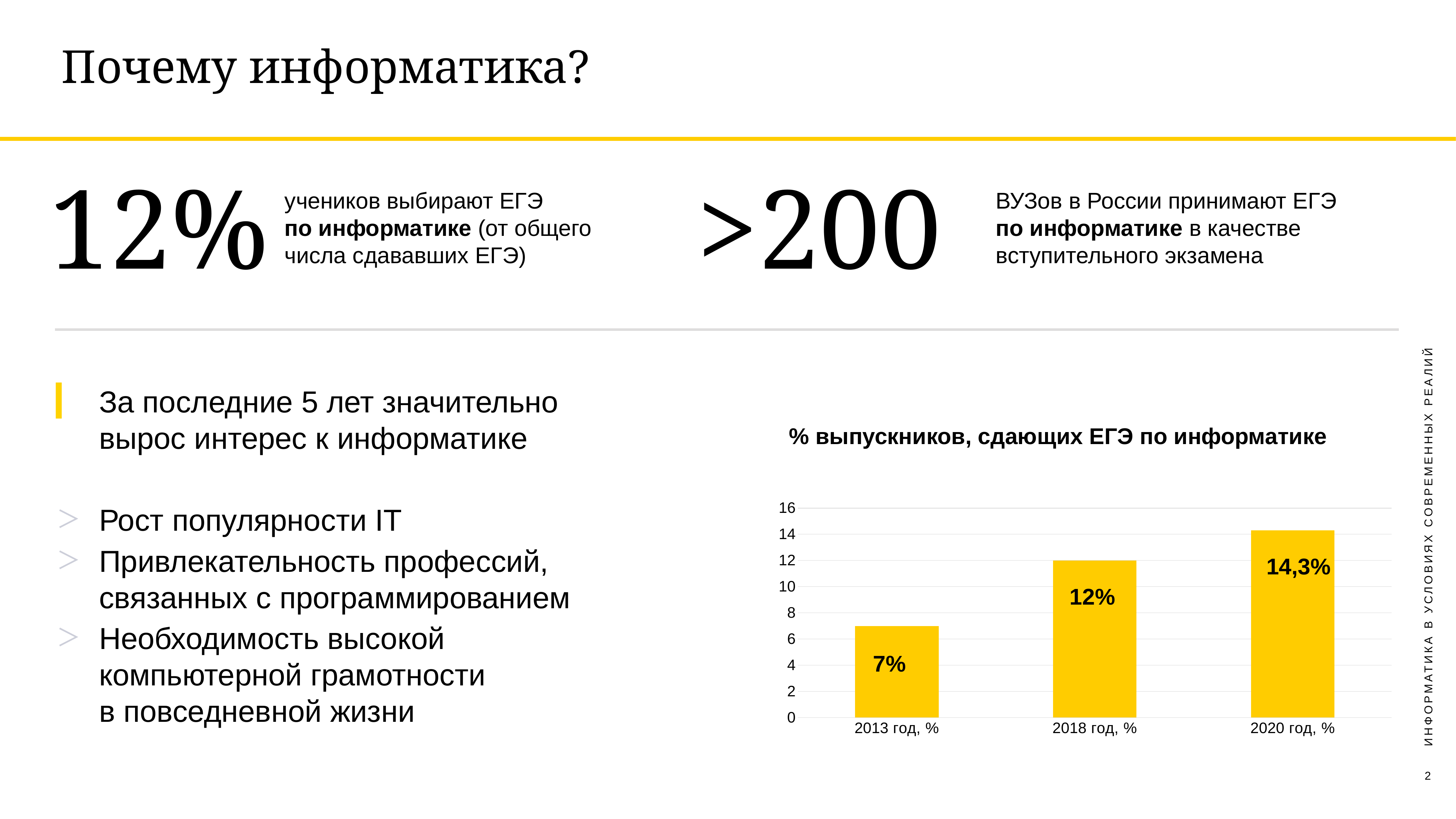
What is the value for 2020 год, %? 14,3% Which category has the lowest value? 2013 год, % Which category has the highest value? 2020 год, % Is the value for 2013 год, % greater or less than 10? less What is the value for 2013 год, %? 7% How many categories are shown on the x axis? 3 What is the title of the chart? % выпускников, сдающих ЕГЭ по информатике What is the value for 2018 год, %? 12% Which is larger, the value for 2018 год, % or the value for 2020 год, %? 2020 год, % What is the difference between the values for 2018 год, % and 2013 год, %? 5% Do the values rise or fall from 2013 to 2020? rise What kind of chart is shown on the slide? bar chart